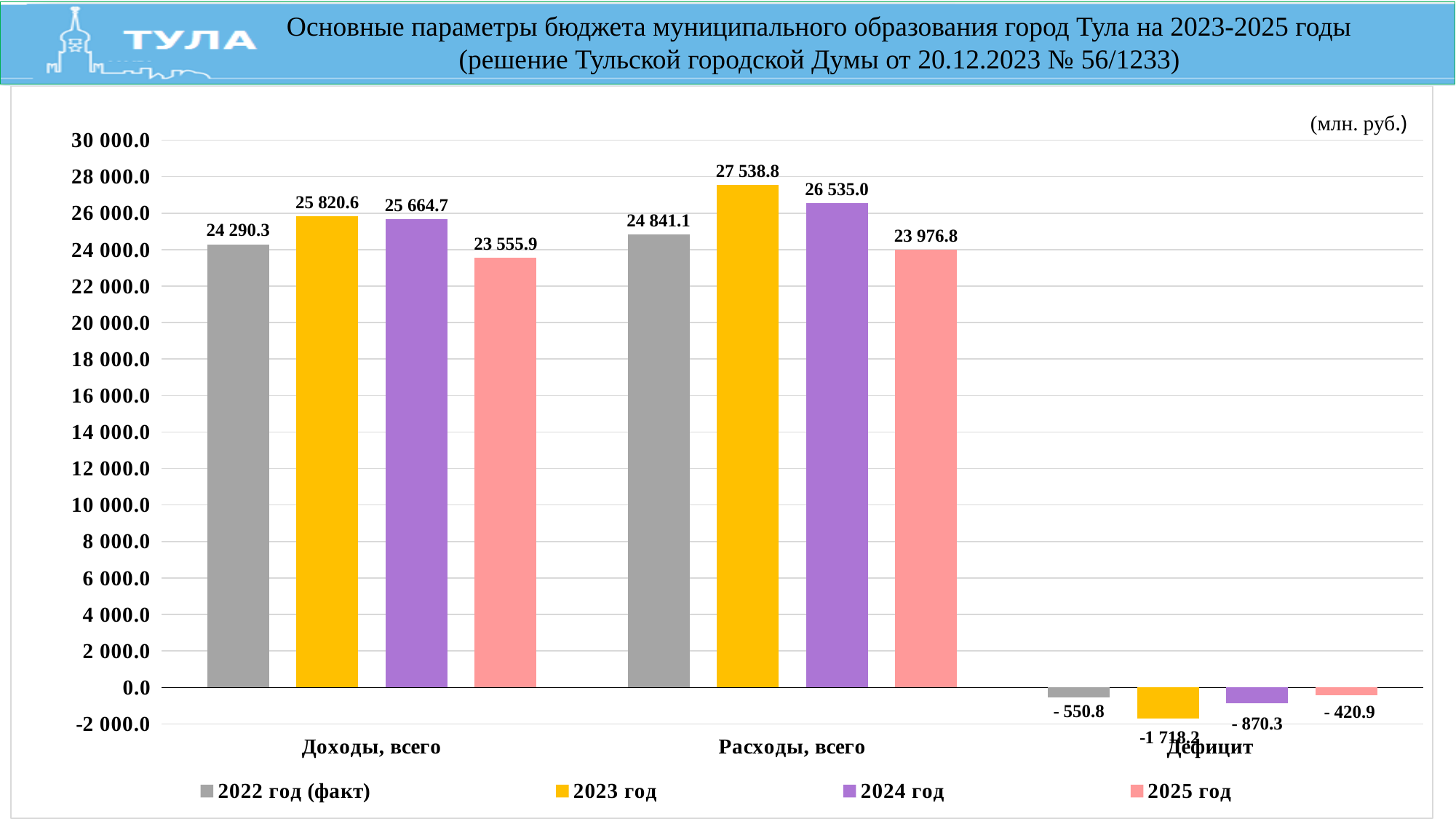
Which year has the highest value in the Расходы, всего category? 2023 год How many categories are shown on the x axis? 3 What is the value for 2024 год in the Расходы, всего category? 26 535.0 Which is larger: the 2024 год value for Доходы, всего or the 2025 год value for Расходы, всего? 2024 год value for Доходы, всего What kind of chart is shown on the slide? Bar chart How many series does the legend list? 4 What is the value for 2023 год in the Доходы, всего category? 25 820.6 What is the difference between the 2023 год and 2022 год (факт) values in the Доходы, всего category? 1 530.3 What is the difference between the 2023 год values for Расходы, всего and Доходы, всего? 1 718.2 What is the value for 2025 год in the Дефицит category? - 420.9 Which year has the lowest value in the Доходы, всего category? 2025 год What is the value for 2022 год (факт) in the Расходы, всего category? 24 841.1